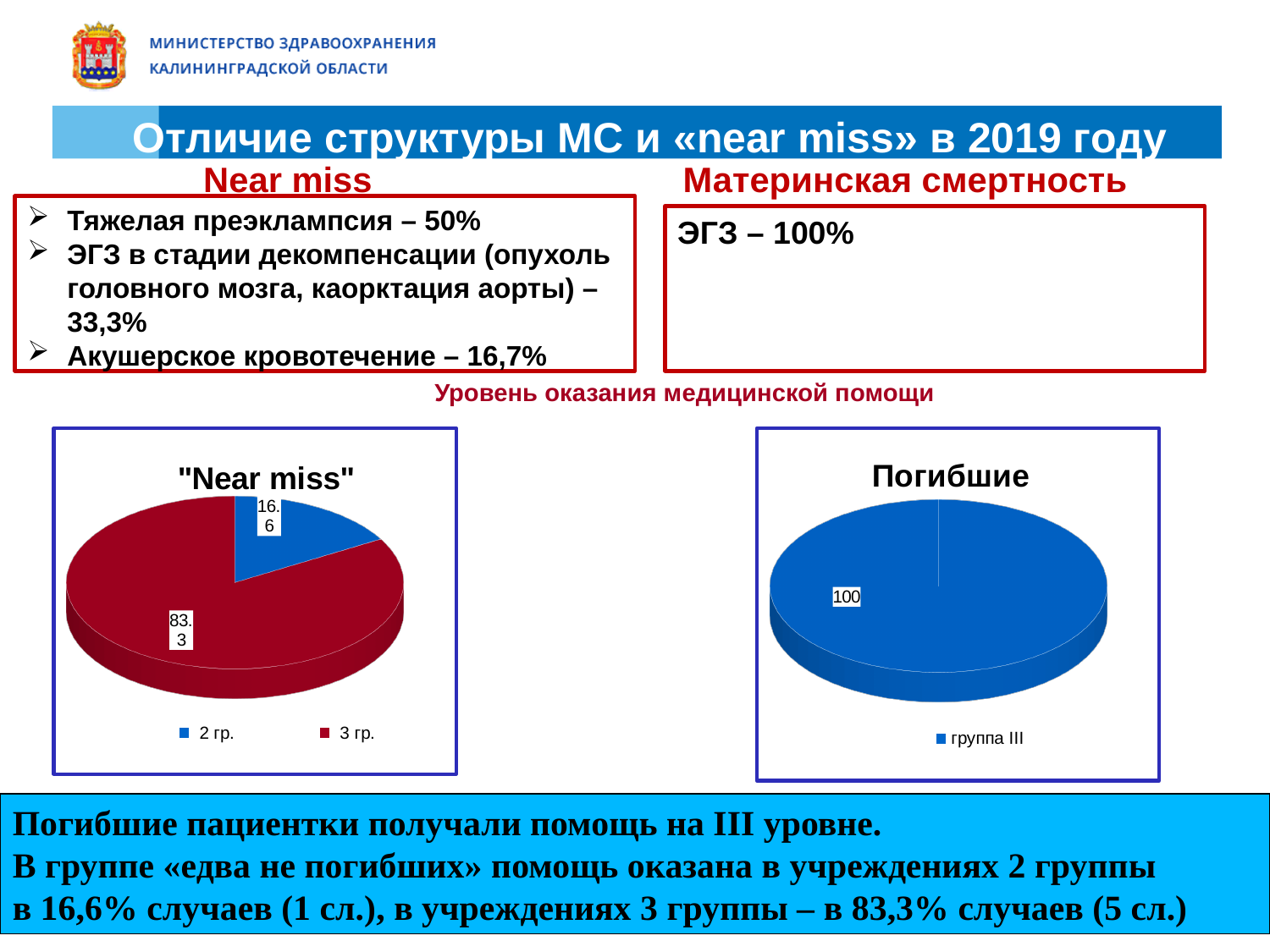
How many slices does the "Near miss" pie chart have? 2 In the "Near miss" chart, what colour is the slice for 3 гр.? red In the "Near miss" chart, what is the value for 3 гр.? 83.3 In the "Near miss" chart, what is the difference between the values for 3 гр. and 2 гр.? 66.7 In the "Near miss" chart, which category has the smallest slice? 2 гр. In the "Погибшие" chart, what is the value for группа III? 100 How many slices does the "Погибшие" pie chart have? 1 In the "Near miss" chart, which is larger: 2 гр. or 3 гр.? 3 гр. How many entries does the legend of the "Near miss" chart list? 2 In the "Near miss" chart, what is the value for 2 гр.? 16.6 What type of chart is the "Near miss" chart? pie chart In the "Near miss" chart, which category has the largest slice? 3 гр.